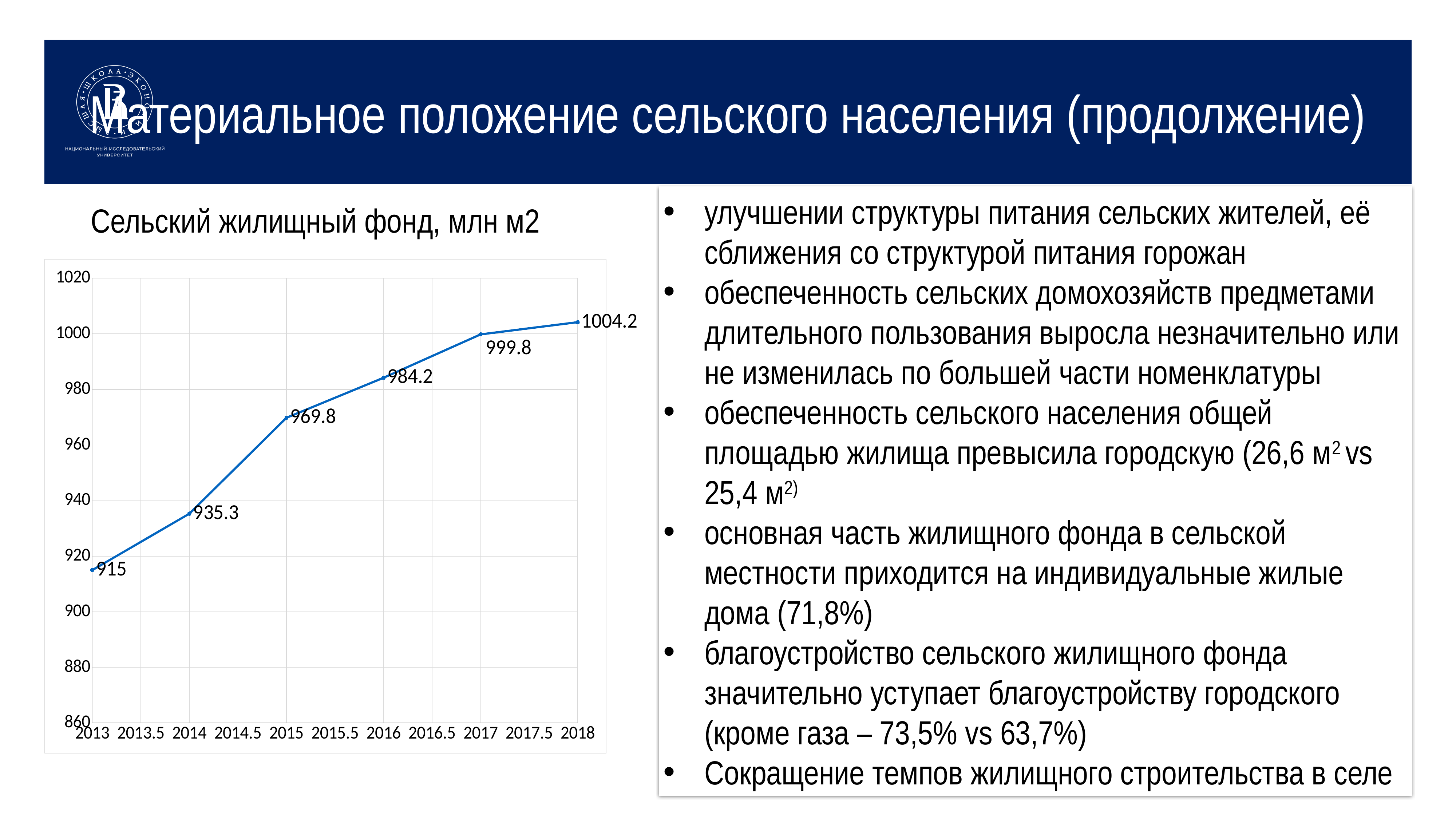
How many data points are plotted in the chart? 6 What is the difference between the values for 2018 and 2013? 89.2 What is the value for 2017 in the chart? 999.8 What kind of chart is shown on the slide? line chart What is the value for 2013 in the chart? 915 Which year has the highest value in the chart? 2018 What is the difference between the values for 2015 and 2014? 34.5 What is the value for 2015 in the chart? 969.8 Do the values rise or fall from 2013 to 2018? rise What is the value for 2018 in the chart? 1004.2 Which year has the lowest value in the chart? 2013 Which is larger, the value for 2016 or the value for 2014? 2016